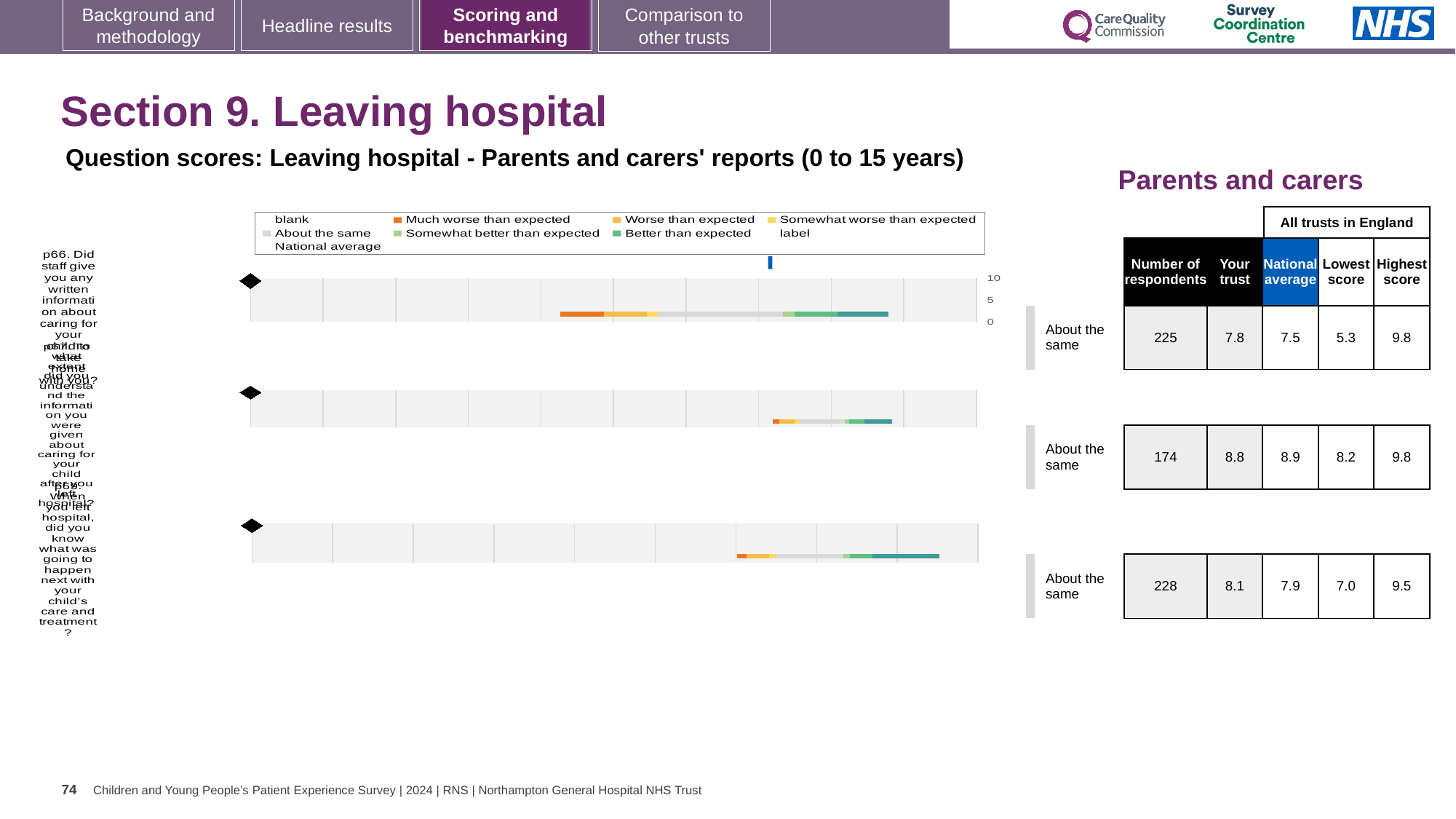
Which question row has the lowest 'Lowest score' value in the table? The first row, p66 (5.3) What benchmark category label is shown next to each of the three question rows? About the same In the table, what is the national average for the third question (p68, knowing what was going to happen next with your child's care and treatment)? 7.9 In the table, what is the 'Your trust' score for the second question row? 8.8 In the legend, what colour represents 'Much worse than expected'? Orange For the first question row (p66), which is larger: the 'Your trust' score or the national average? Your trust (7.8) Which question row has the highest 'Your trust' score in the table? The second row (8.8) In the table, how many respondents answered the first question (p66, written information about caring for your child at home)? 225 For the second question row, which is larger: the 'Your trust' score or the national average? National average (8.9) How many question rows (charts) are shown on the slide? 3 In the table, what is the highest score across all trusts in England for the third question row? 9.5 For the first question row (p66), what is the difference between the 'Your trust' score and the national average? 0.3